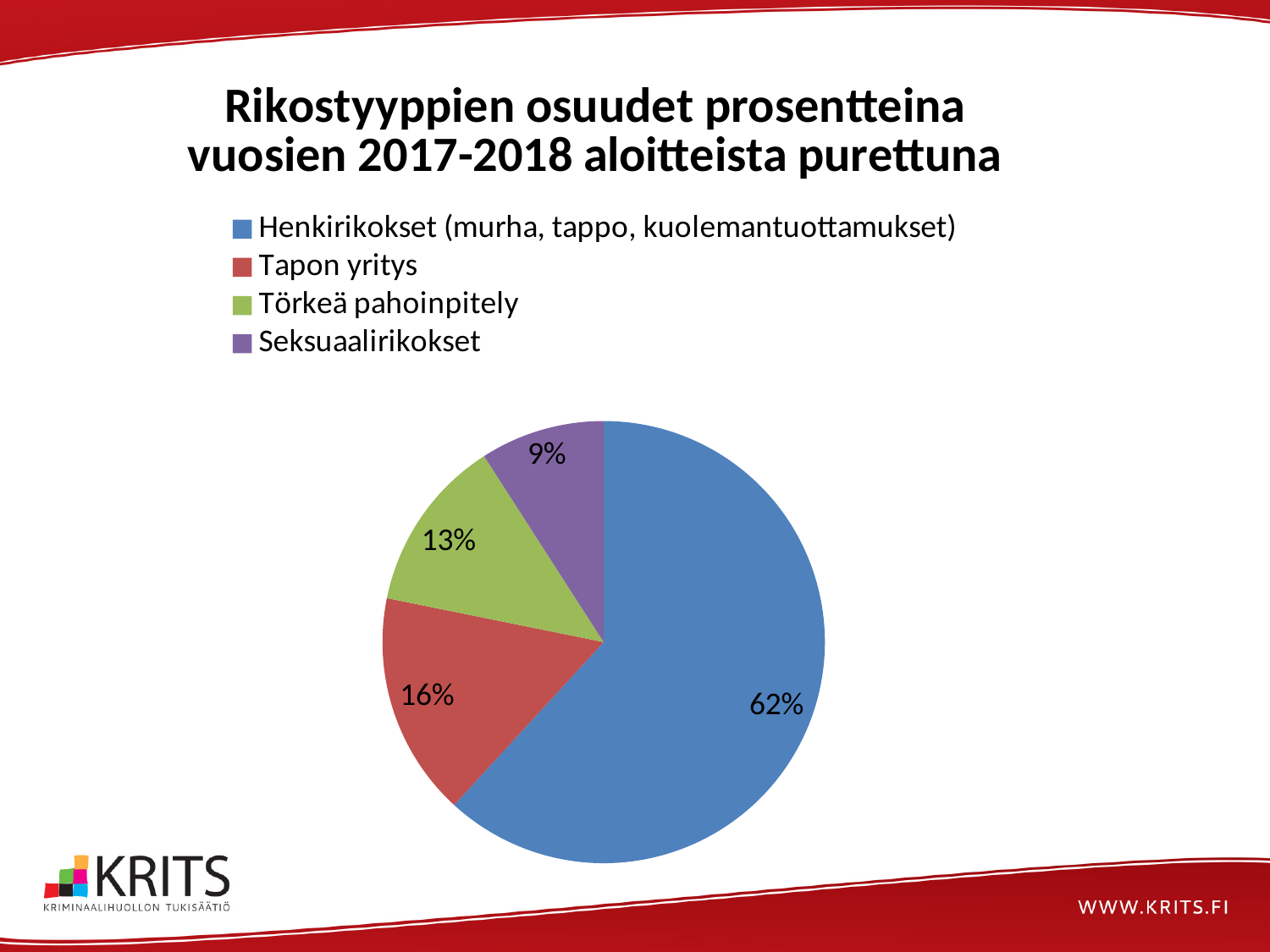
What is the title of the chart? Rikostyyppien osuudet prosentteina vuosien 2017-2018 aloitteista purettuna How many categories does the pie chart show? 4 Which category has the smallest slice of the pie? Seksuaalirikokset Which is larger, the share for Tapon yritys or the share for Seksuaalirikokset? Tapon yritys What share of the pie does Törkeä pahoinpitely have? 13% What is the difference in percentage points between Tapon yritys and Törkeä pahoinpitely? 3 What colour is the slice for Törkeä pahoinpitely? Green Which category has the largest slice of the pie? Henkirikokset (murha, tappo, kuolemantuottamukset) What share of the pie does Seksuaalirikokset have? 9% What share of the pie does Henkirikokset (murha, tappo, kuolemantuottamukset) have? 62% What type of chart is shown on the slide? Pie chart